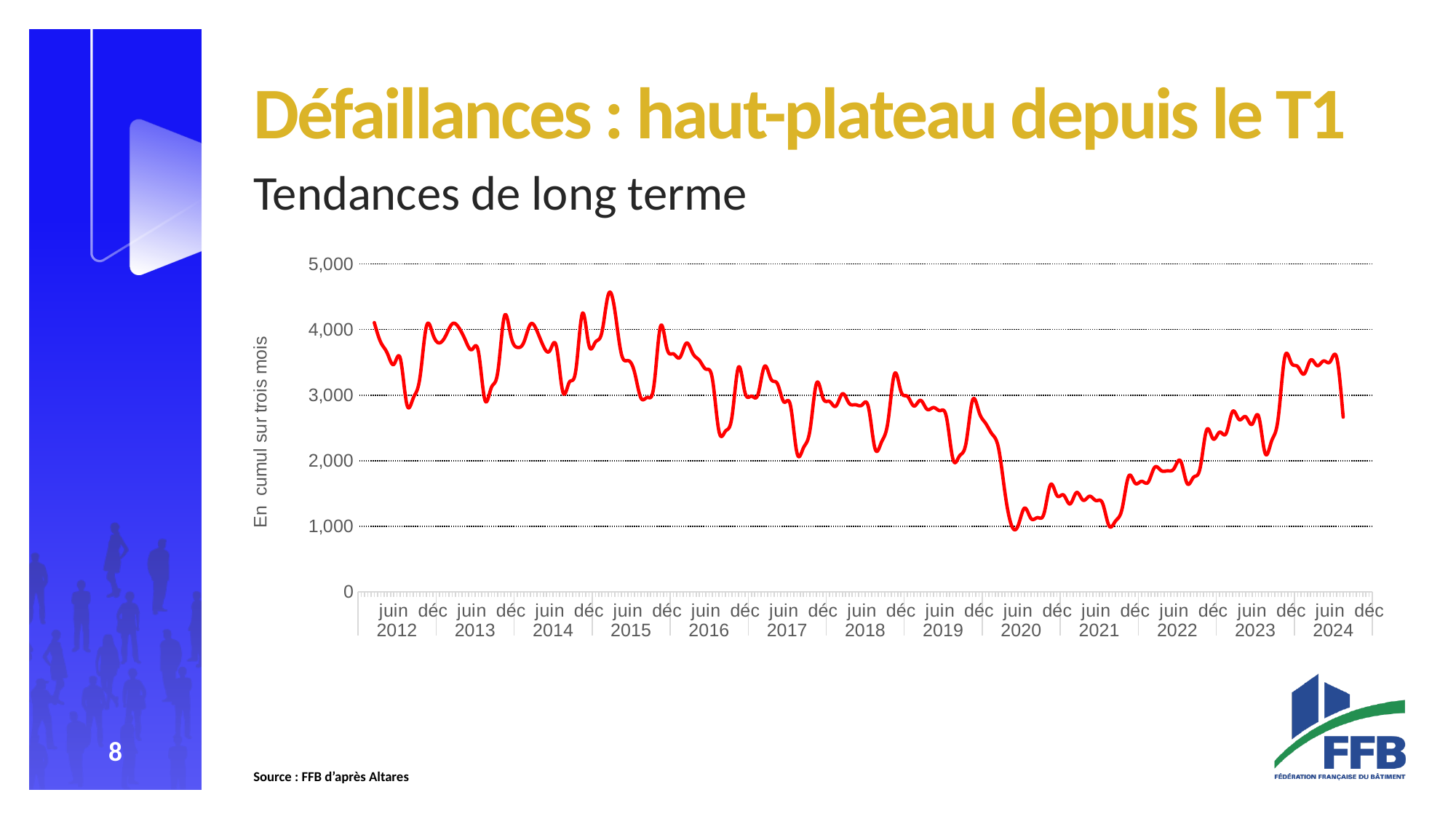
Between 2020 and 2023, does the line generally rise or fall? rise In which year does the line reach its highest point? 2015 What is the label on the vertical axis of the chart? En cumul sur trois mois Is the value in juin 2021 greater or less than 2,000? less Between 2012 and 2020, does the line generally rise or fall? fall What kind of chart is shown on the slide? line chart Is the value in juin 2012 greater or less than 3,000? greater Is the value in juin 2020 greater or less than 2,000? less What is the title of the slide above the chart? Défaillances : haut-plateau depuis le T1 Which is larger, the value in juin 2012 or the value in juin 2020? juin 2012 How many years are labelled on the horizontal axis? 13